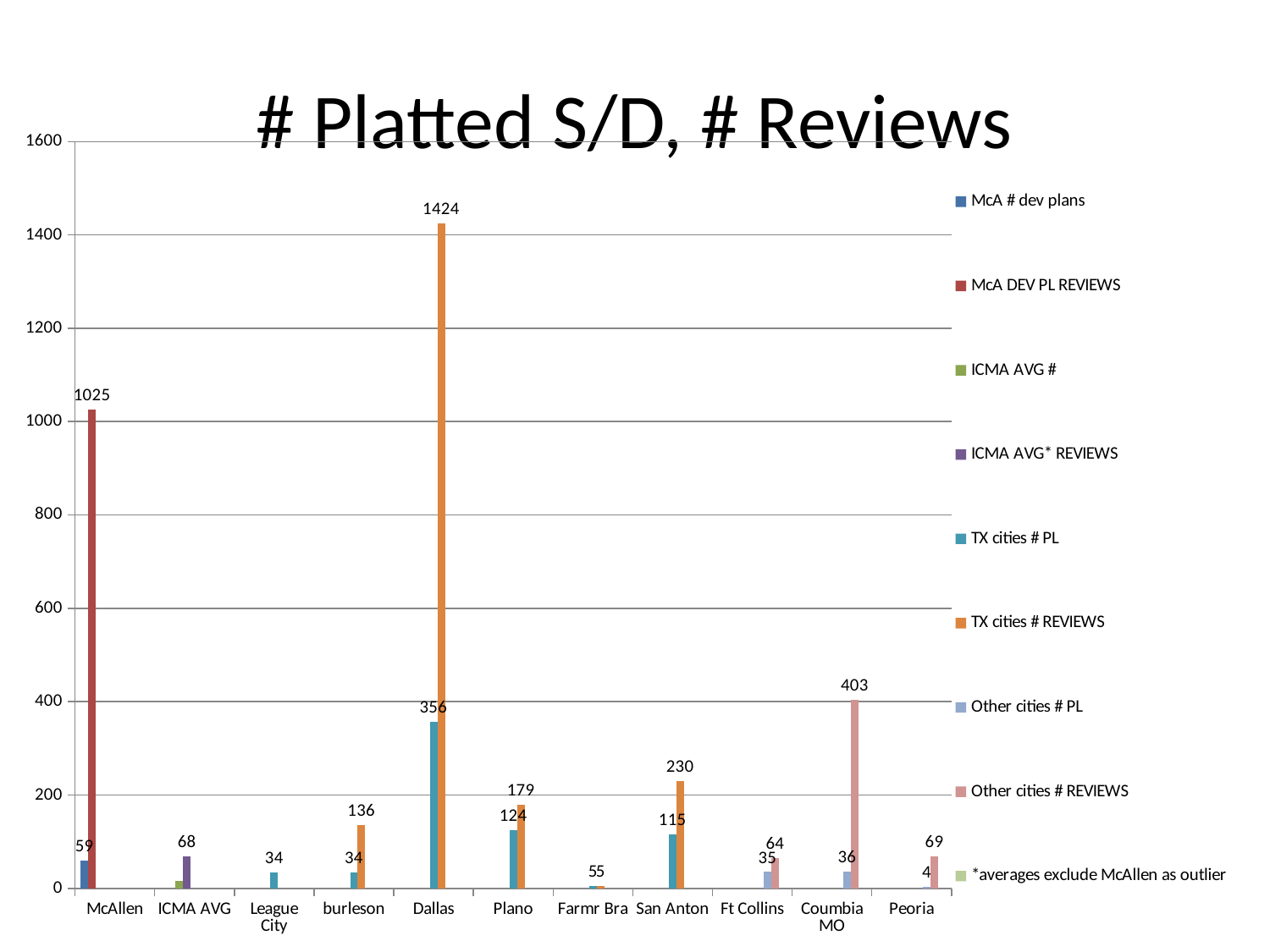
What is the TX cities # PL value for Plano? 124 What kind of chart is shown on the slide? bar chart What is the title of the chart? # Platted S/D, # Reviews What is the difference between the TX cities # REVIEWS and TX cities # PL values for Dallas? 1068 How many categories are shown on the x axis? 11 Which category has the highest TX cities # REVIEWS value? Dallas What is the difference between the McA DEV PL REVIEWS and McA # dev plans values for McAllen? 966 What is the TX cities # REVIEWS value for Dallas? 1424 What is the Other cities # REVIEWS value for Coumbia MO? 403 Is the ICMA AVG # value for ICMA AVG greater or less than 200? less What is the McA DEV PL REVIEWS value for McAllen? 1025 Which is larger: the Other cities # REVIEWS value for Coumbia MO or the TX cities # REVIEWS value for San Anton? Coumbia MO